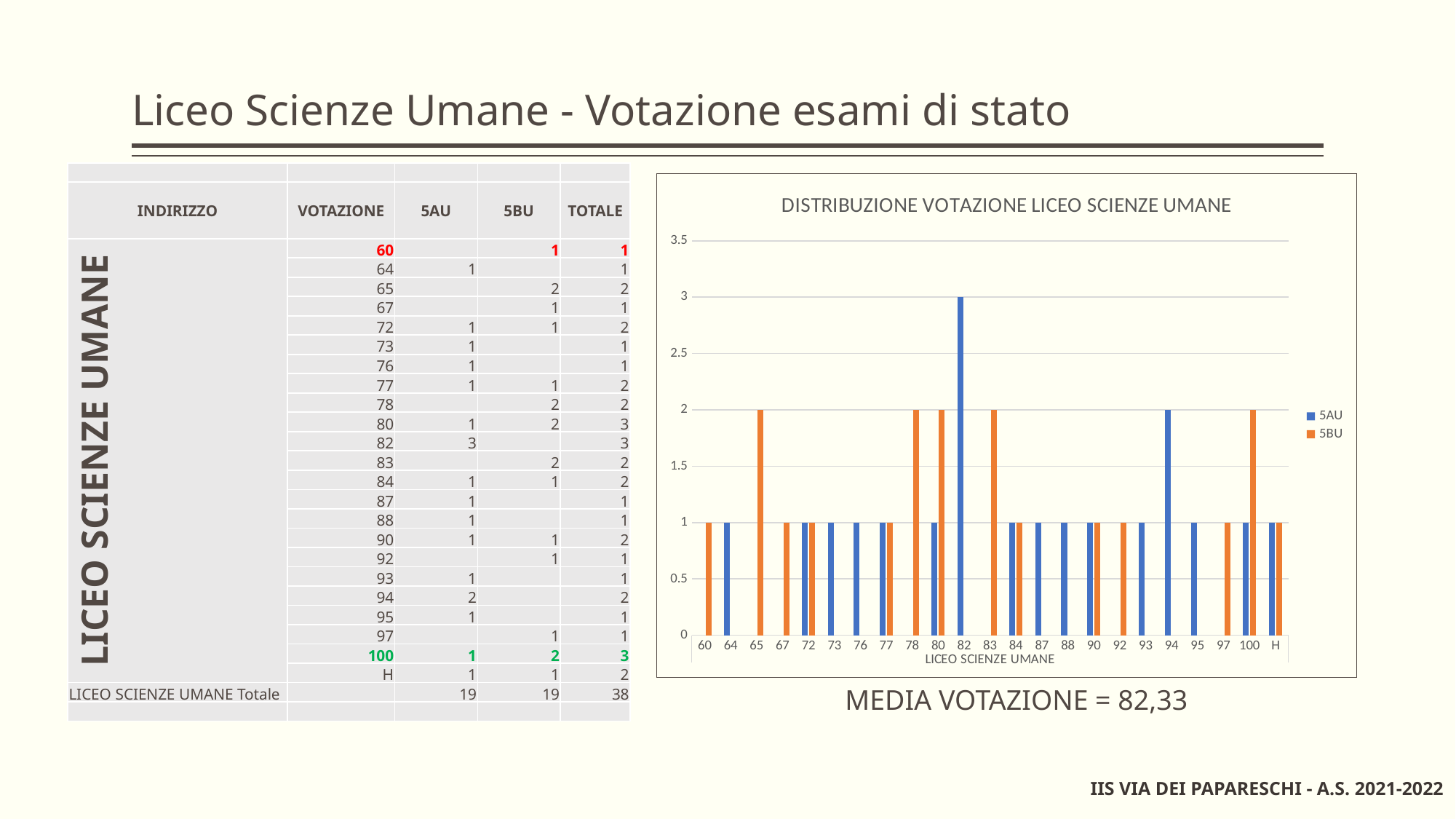
What is the difference between the 5AU value at 82 and the 5BU value at 65? 1 What kind of chart is shown on the slide? bar chart How many series does the chart legend list? 2 Is the value for 5AU at votazione 82 greater or less than 2.5? greater How many categories are shown on the x axis of the chart? 23 Which is larger at votazione 80: the 5AU value or the 5BU value? 5BU What is the value for 5AU at votazione 94? 2 What is the title of the chart? DISTRIBUZIONE VOTAZIONE LICEO SCIENZE UMANE Which votazione has the highest value for the 5AU series? 82 What is the value for 5BU at votazione 100? 2 What is the value for 5AU at votazione 82? 3 Which colour represents the 5BU series in the chart? orange